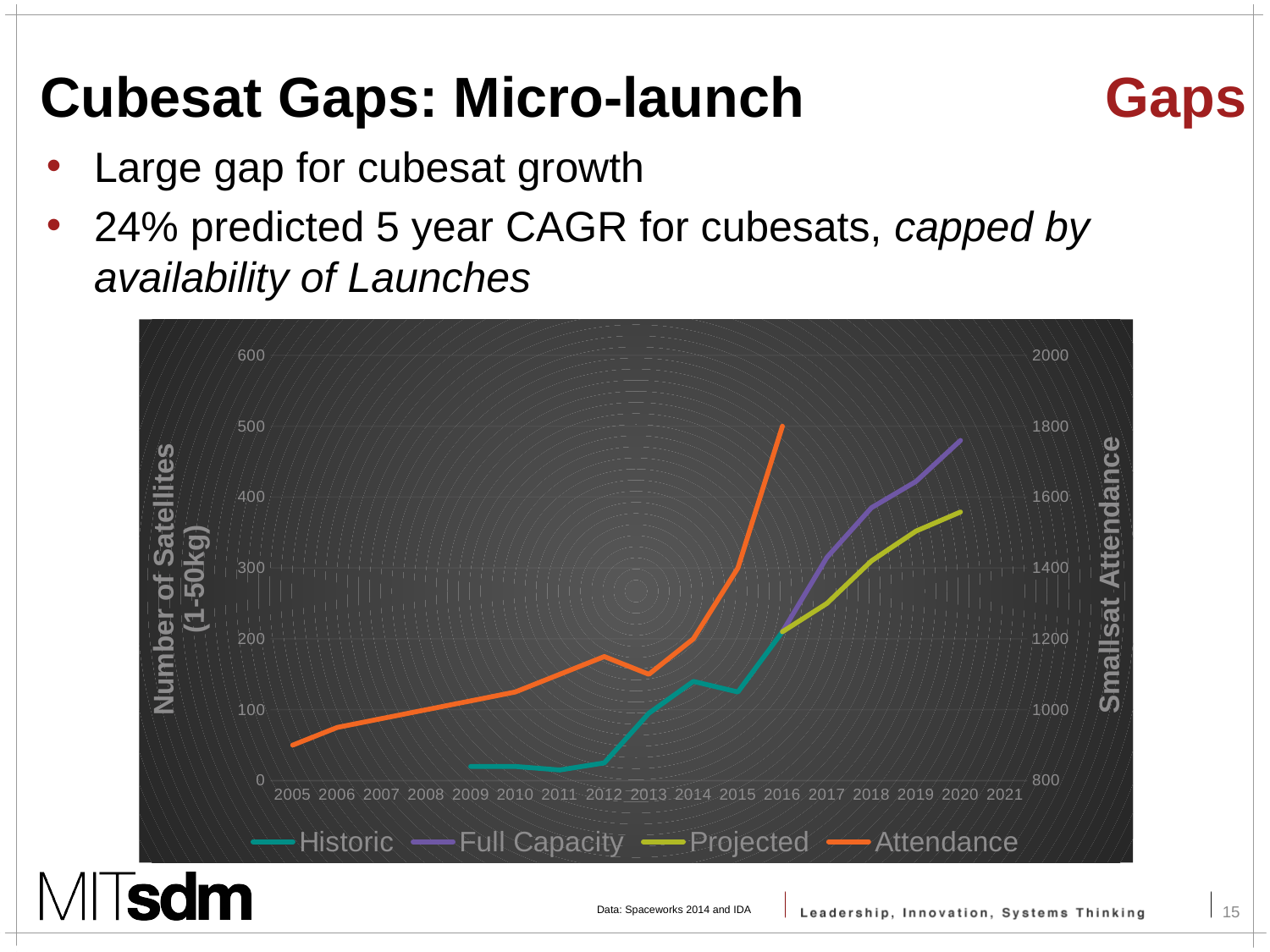
In 2020, which series is higher: Full Capacity or Projected? Full Capacity How many years are labelled along the x axis of the chart? 17 Does the Historic series rise or fall overall from 2009 to 2016? rise Is the Historic value for 2014 greater or less than 100? greater Is the Full Capacity value for 2020 greater or less than 400? greater What kind of chart is shown on the slide? line chart Is the Projected value for 2020 greater or less than 400? less Does the Attendance series rise or fall from 2005 to 2016? rise What is the title of the left vertical axis of the chart? Number of Satellites (1-50kg) What are the four series listed in the chart legend? Historic, Full Capacity, Projected, Attendance How many series does the chart legend list? 4